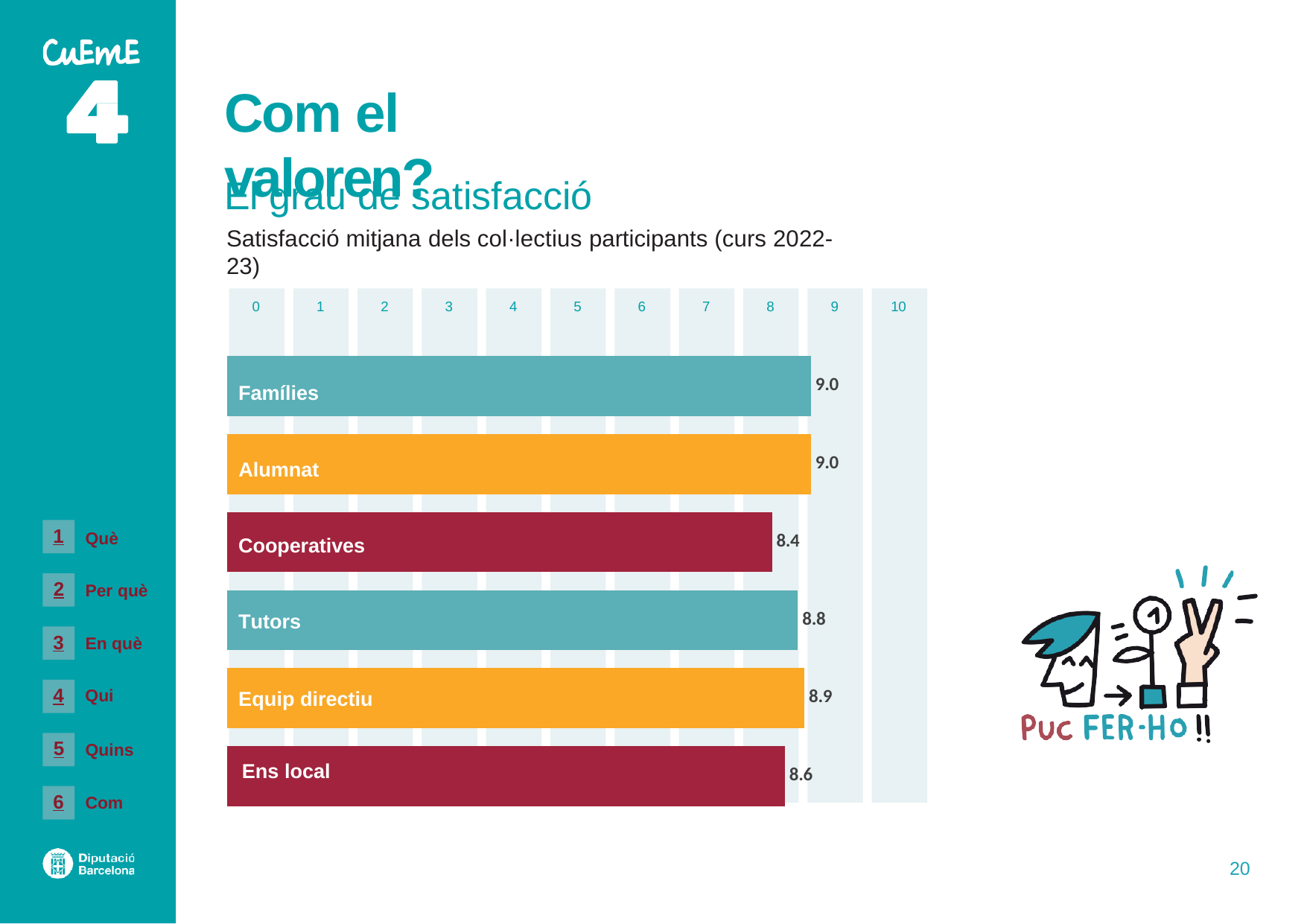
Which has a higher value, Tutors or Ens local? Tutors What is the satisfaction value for Tutors? 8.8 Which category has the lowest satisfaction value? Cooperatives Is the value for Cooperatives greater or less than 9? less What is the satisfaction value for Famílies? 9.0 What is the satisfaction value for Cooperatives? 8.4 What is the difference between the values for Famílies and Cooperatives? 0.6 What kind of chart is shown on the slide? bar chart How many categories are shown in the chart? 6 What is the satisfaction value for Equip directiu? 8.9 What is the satisfaction value for Ens local? 8.6 What is the difference between the values for Equip directiu and Ens local? 0.3